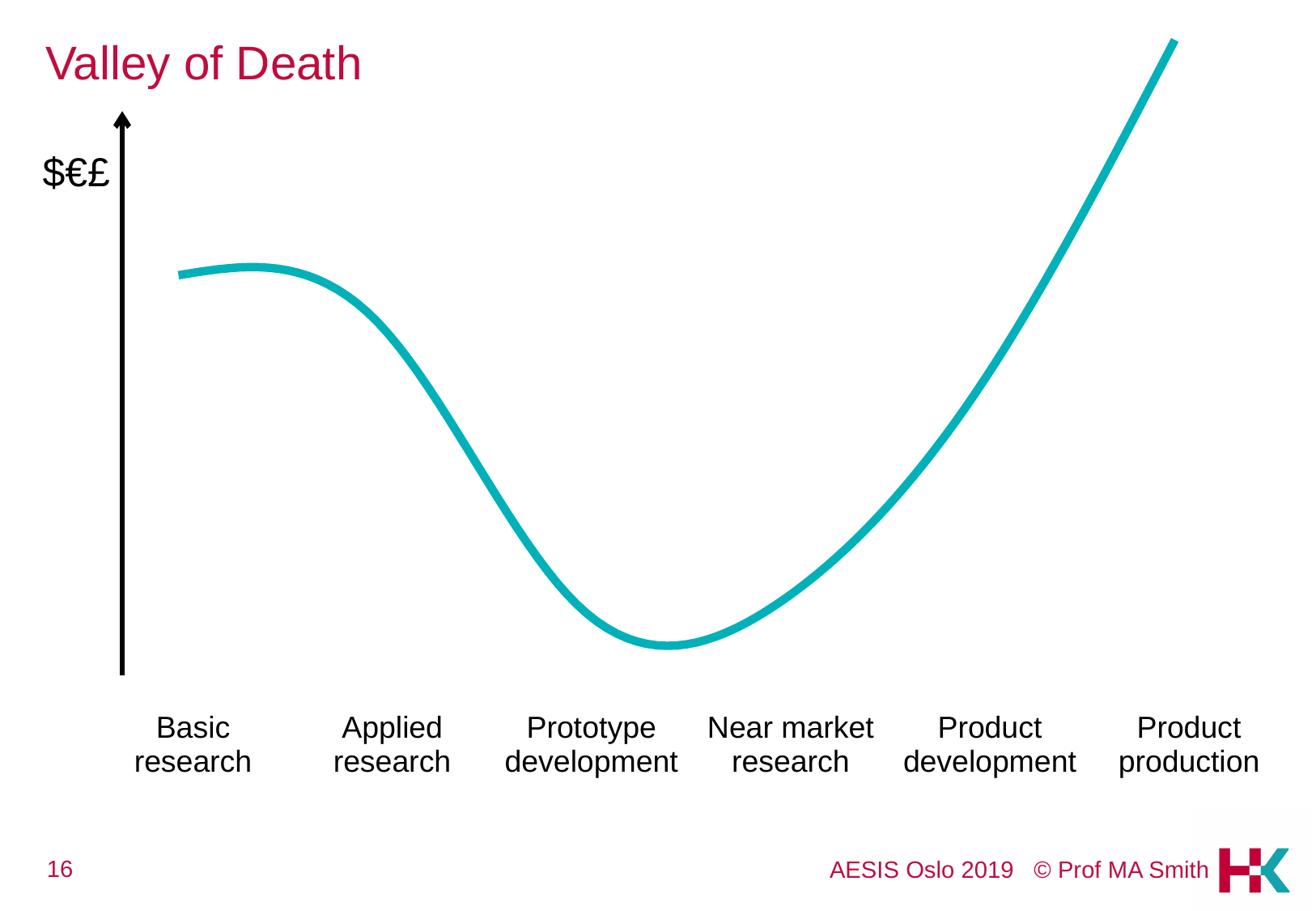
How many stages are labelled along the x axis? 6 Does the curve rise or fall between Applied research and Prototype development? fall Which is higher on the curve, Basic research or Product production? Product production Which stage has the highest value on the curve? Product production What kind of chart is shown on the slide? line chart What label is shown on the vertical axis? $€£ Does the curve rise or fall between Near market research and Product production? rise Which is higher on the curve, Near market research or Product development? Product development Which is higher on the curve, Basic research or Prototype development? Basic research What is the first stage labelled on the x axis? Basic research What is the title of the chart? Valley of Death How many lines are plotted on the chart? 1